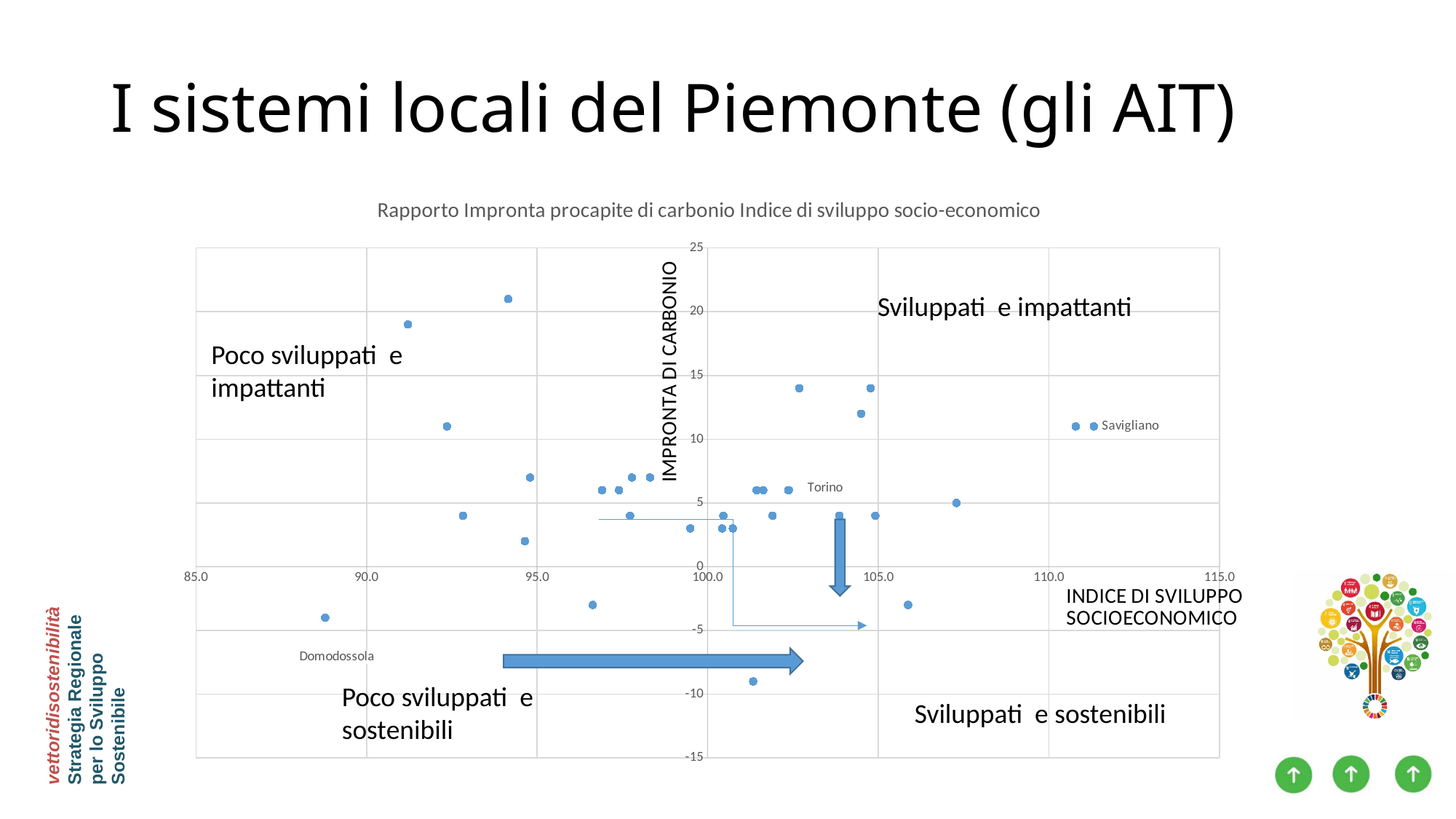
Is the carbon footprint value for Domodossola greater or less than 0? less Is the socio-economic index value for Domodossola greater or less than 90.0? less What kind of chart is shown on the slide? Scatter chart Which has the higher carbon footprint, Savigliano or Domodossola? Savigliano Which has the higher socio-economic index, Savigliano or Torino? Savigliano Is the socio-economic index value for Savigliano greater or less than 110.0? greater Which of the three labelled points (Savigliano, Torino, Domodossola) has the lowest socio-economic index? Domodossola What is the title of the chart? Rapporto Impronta procapite di carbonio Indice di sviluppo socio-economico What is the label of the vertical axis of the chart? IMPRONTA DI CARBONIO Which has the lower carbon footprint, Torino or Domodossola? Domodossola